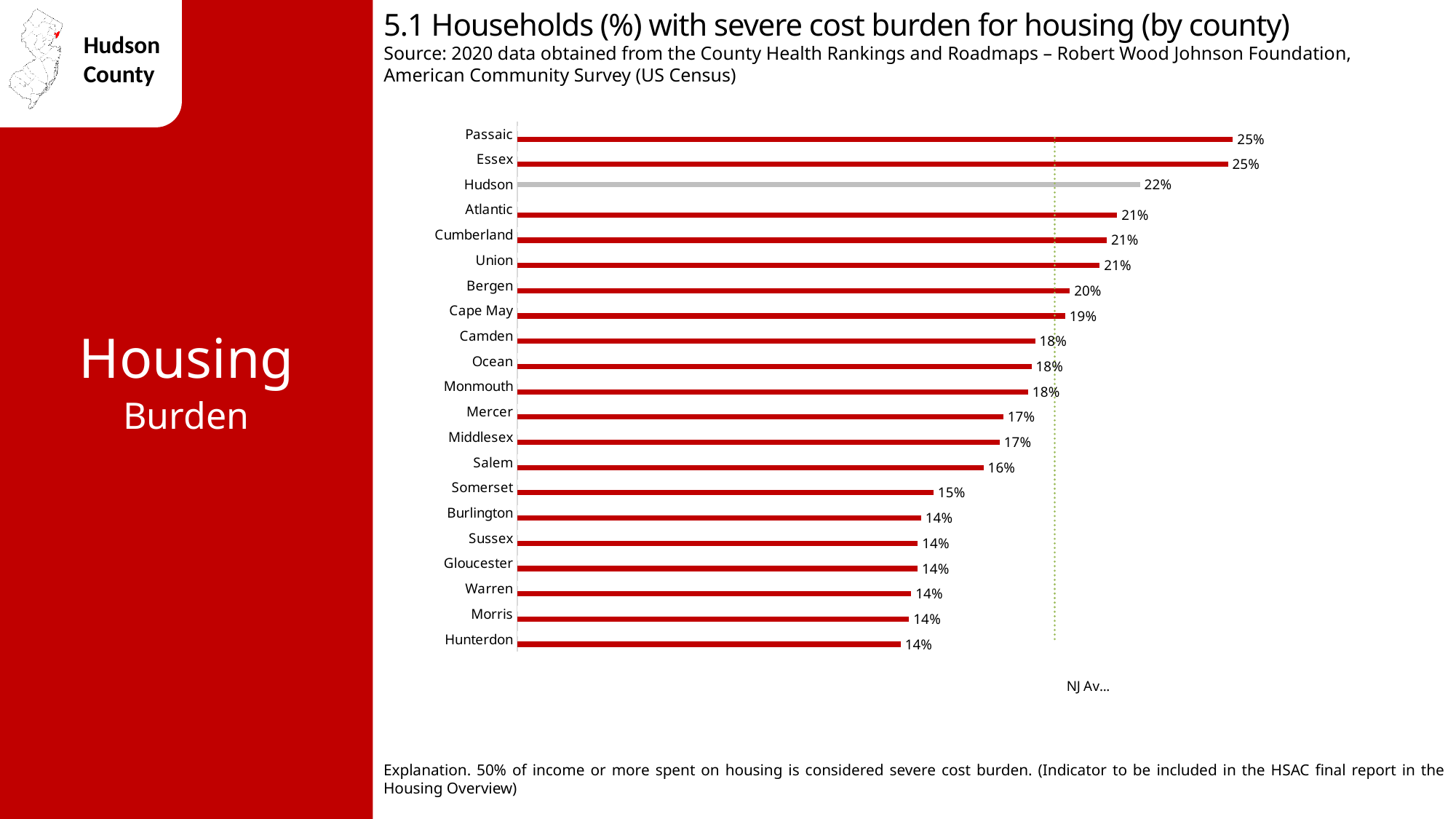
What is the difference between the values for Hudson and Bergen? 2 percentage points Which has a larger value, Salem or Somerset? Salem What is the difference between the values for Passaic and Hunterdon? 11 percentage points What is the value for Hunterdon? 14% What is the value for Passaic? 25% What is the value for Salem? 16% How many counties are shown in the chart? 21 What is the value for Bergen? 20% What is the value for Hudson? 22% What kind of chart is shown on the slide? Bar chart Which county's bar is coloured grey instead of red? Hudson Which has a larger value, Hudson or Atlantic? Hudson